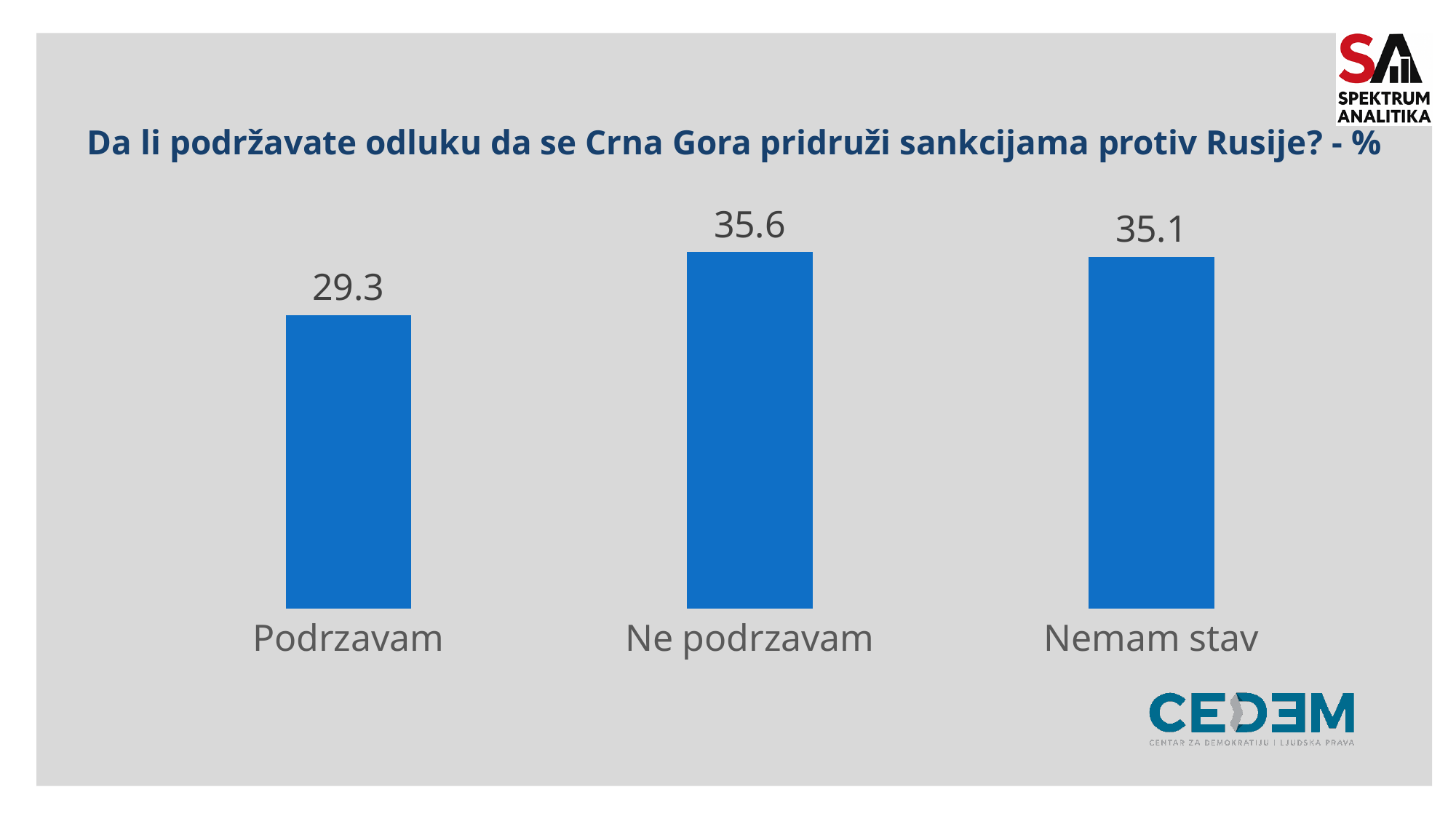
How many categories are shown in the chart? 3 What is the difference between the values for Nemam stav and Podrzavam? 5.8 Which category has the highest value? Ne podrzavam What is the title of the chart? Da li podržavate odluku da se Crna Gora pridruži sankcijama protiv Rusije? - % What is the value for Ne podrzavam? 35.6 What is the value for Nemam stav? 35.1 What kind of chart is shown on the slide? Bar chart What is the value for Podrzavam? 29.3 What is the difference between the values for Ne podrzavam and Podrzavam? 6.3 Which is larger, the value for Podrzavam or the value for Nemam stav? Nemam stav What is the difference between the values for Ne podrzavam and Nemam stav? 0.5 Which category has the lowest value? Podrzavam